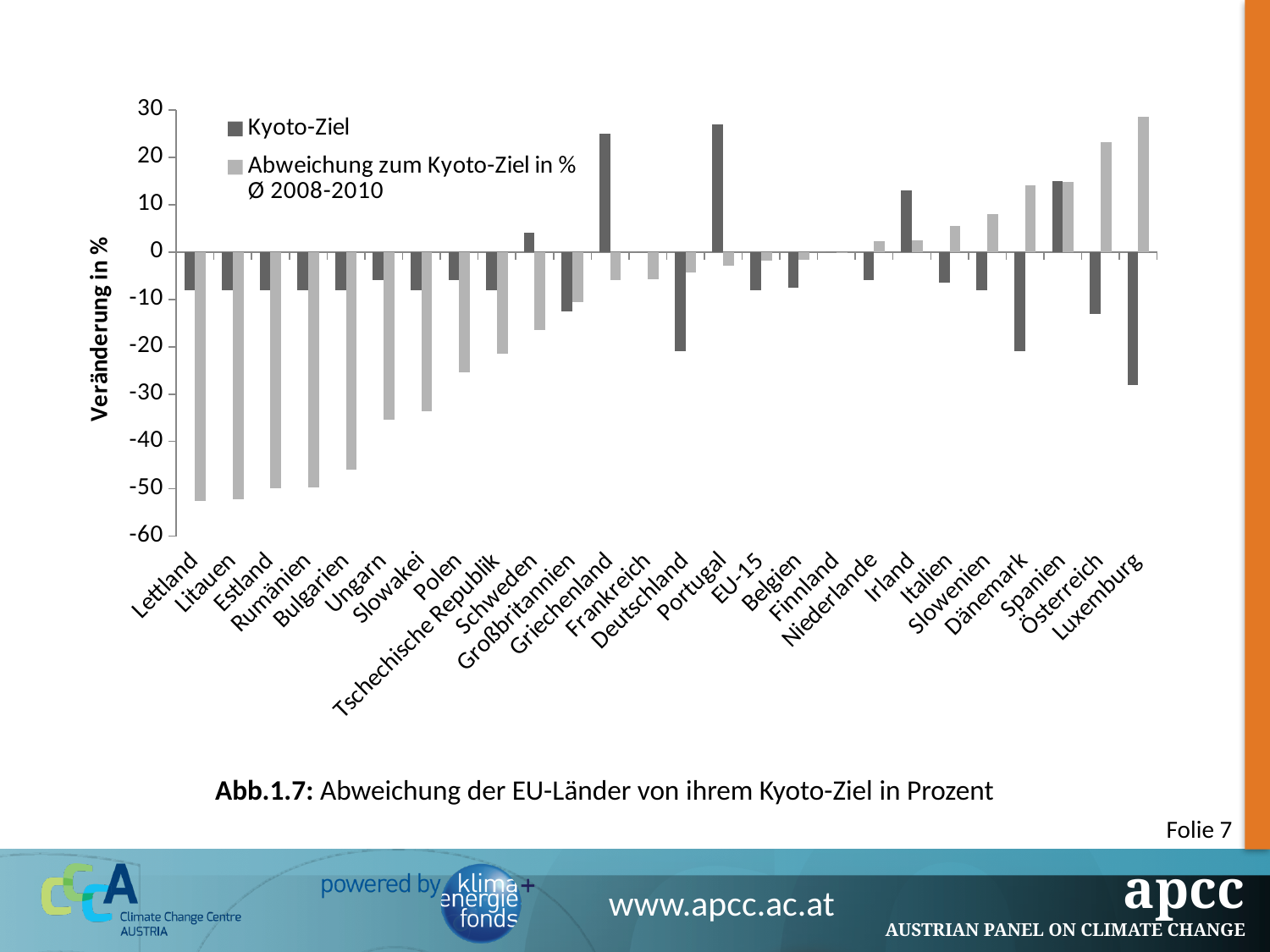
Is the 'Abweichung zum Kyoto-Ziel in % Ø 2008-2010' value for Luxemburg greater or less than 20? greater Is the 'Abweichung zum Kyoto-Ziel in % Ø 2008-2010' value for Bulgarien greater or less than -40? less What is the label of the vertical axis? Veränderung in % Is the 'Kyoto-Ziel' value for Portugal greater or less than 20? greater Which category has the highest value for 'Abweichung zum Kyoto-Ziel in % Ø 2008-2010'? Luxemburg Which category has the lowest value for 'Kyoto-Ziel'? Luxemburg How many series does the legend list? 2 What kind of chart is shown on the slide? bar chart How many countries/categories are shown on the x axis? 26 Which has the larger 'Abweichung zum Kyoto-Ziel in % Ø 2008-2010' value, Österreich or Spanien? Österreich